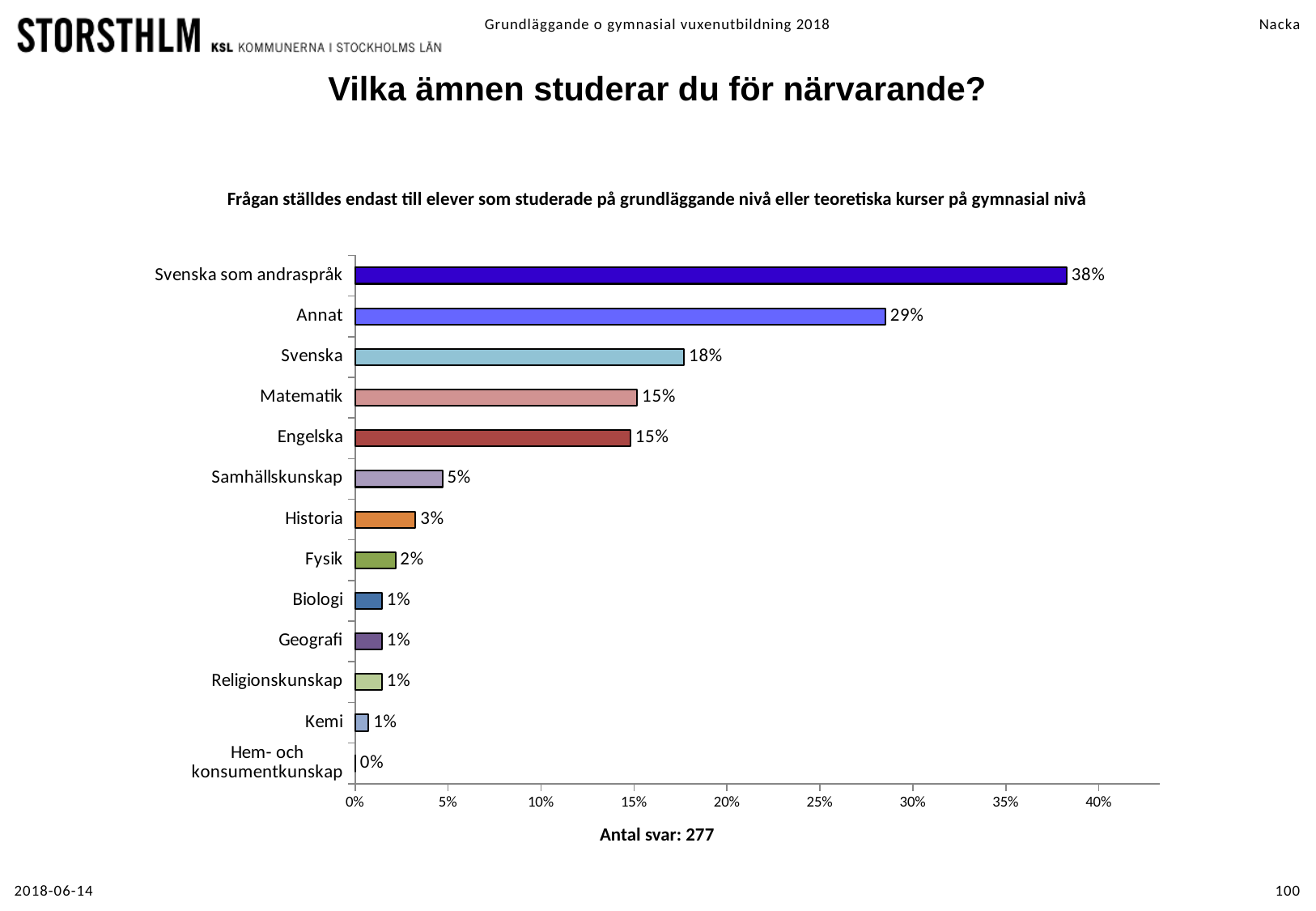
What kind of chart is shown on the slide? Bar chart What is the value for Matematik? 15% What is the number of responses (Antal svar) shown below the chart? 277 Which category has the lowest value? Hem- och konsumentkunskap How many categories are shown in the chart? 13 What is the value for Historia? 3% What is the title of the slide? Vilka ämnen studerar du för närvarande? Is the value for Annat greater or less than 25%? greater What is the difference between the values for Svenska som andraspråk and Annat? 9 percentage points What is the value for Svenska som andraspråk? 38% Which category has the highest value? Svenska som andraspråk Which is larger, the value for Svenska or the value for Samhällskunskap? Svenska